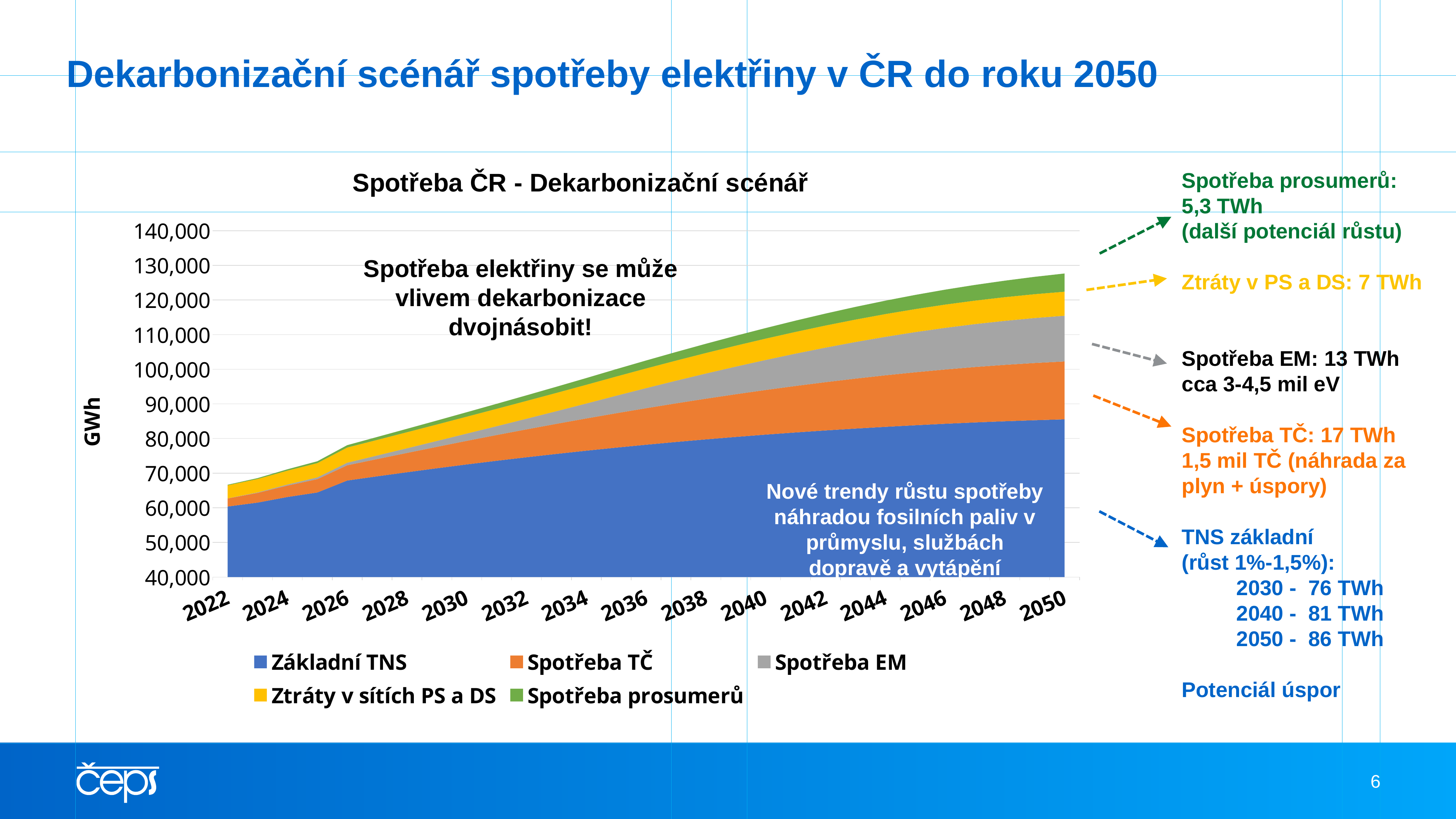
What is the title of the chart? Spotřeba ČR - Dekarbonizační scénář Is the value of Základní TNS in 2050 greater or less than 80,000 GWh? greater According to the annotations, which is larger in 2050: Spotřeba TČ or Spotřeba EM? Spotřeba TČ According to the annotation on the slide, what is the value of Základní TNS in 2040? 81 TWh How many year labels are shown on the x axis of the chart? 15 How many series does the chart legend list? 5 What unit is shown on the vertical axis of the chart? GWh What kind of chart is shown on the slide? Area chart Is the total stacked value for 2050 greater or less than 120,000 GWh? greater Which series has the largest value in 2050? Základní TNS Does total consumption in the chart rise or fall from 2022 to 2050? Rise Is the total stacked value for 2022 greater or less than 70,000 GWh? less